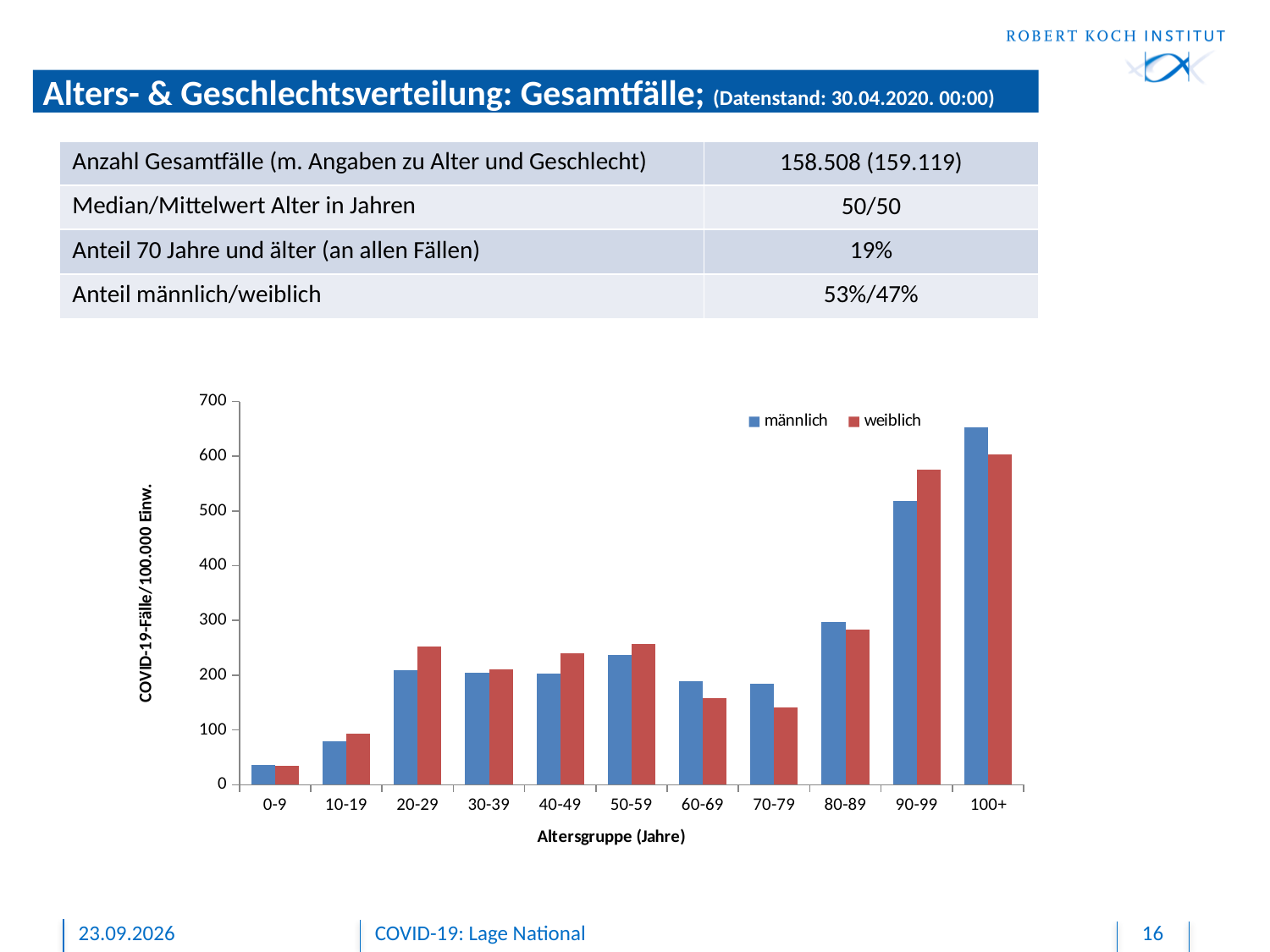
How many age groups are shown on the x axis of the chart? 11 In the 20-29 age group, which series has the larger value, männlich or weiblich? weiblich Which age group has the lowest value for weiblich? 0-9 How many series does the chart legend list? 2 What is the title of the y axis of the chart? COVID-19-Fälle/100.000 Einw. Is the value for weiblich in the 80-89 age group greater or less than 300? less In the 100+ age group, which series has the larger value, männlich or weiblich? männlich Which age group has the highest value for männlich? 100+ What kind of chart is shown on the slide? bar chart In the 70-79 age group, which series has the larger value, männlich or weiblich? männlich Is the value for männlich in the 90-99 age group greater or less than 500? greater Do the männlich values rise or fall from the 70-79 age group to the 100+ age group? rise